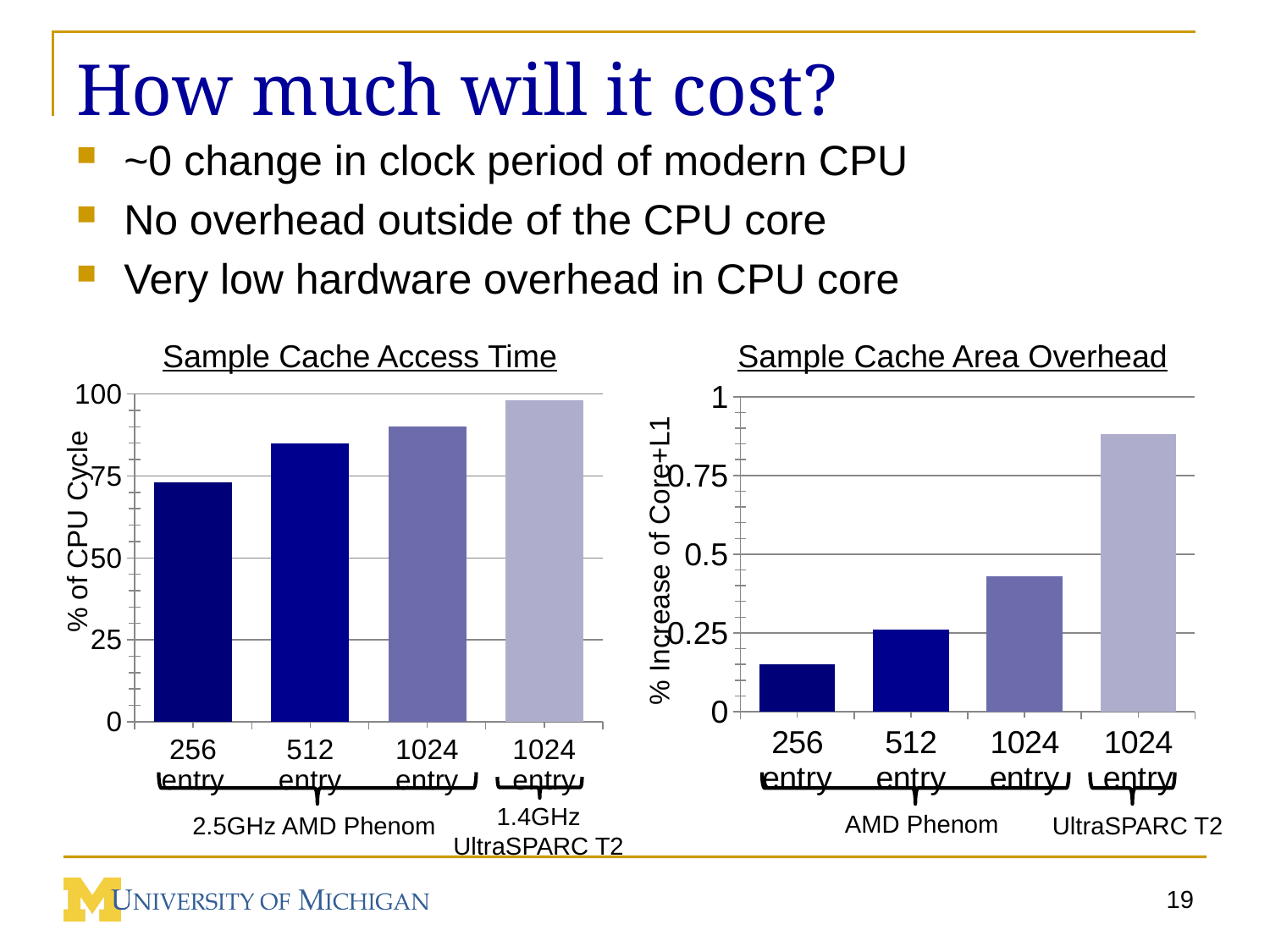
In the Sample Cache Area Overhead chart, which is larger, the value for 512 entry or the value for 1024 entry (AMD Phenom)? 1024 entry (AMD Phenom) What is the y-axis label of the Sample Cache Access Time chart? % of CPU Cycle In the Sample Cache Access Time chart, is the value for 256 entry greater or less than 50? greater In the Sample Cache Access Time chart, which category has the lowest value? 256 entry In the Sample Cache Area Overhead chart, is the value for 1024 entry (UltraSPARC T2) greater or less than 0.75? greater In the Sample Cache Access Time chart, which category has the highest value? 1024 entry (UltraSPARC T2) In the Sample Cache Area Overhead chart, is the value for 512 entry greater or less than 0.5? less In the Sample Cache Access Time chart, do the values rise or fall from left to right along the x axis? rise What kind of chart is the Sample Cache Access Time chart? bar chart In the Sample Cache Area Overhead chart, which category has the lowest value? 256 entry How many bars are plotted in the Sample Cache Area Overhead chart? 4 In the Sample Cache Area Overhead chart, which category has the highest value? 1024 entry (UltraSPARC T2)